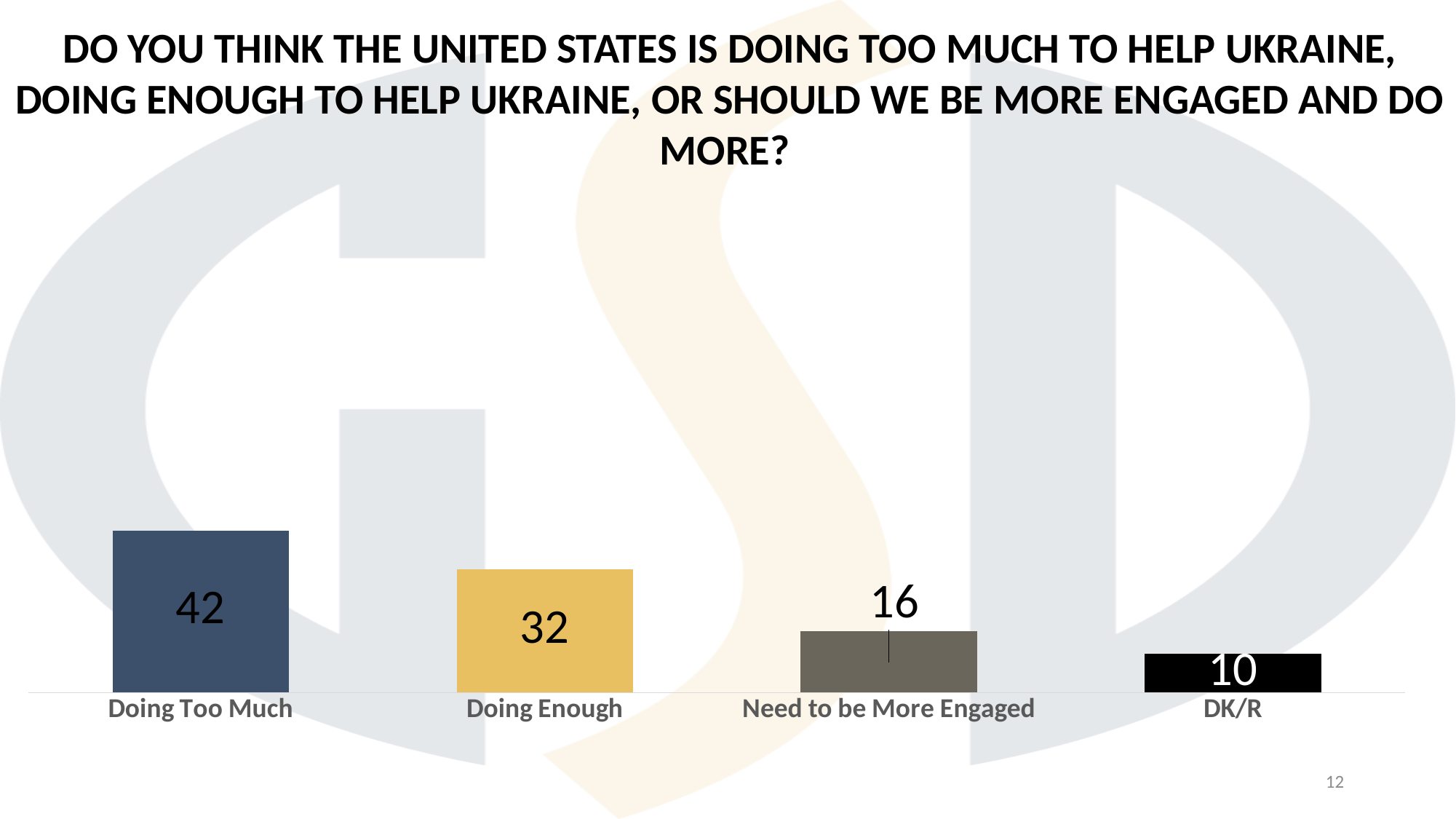
What is the difference between the values for Doing Too Much and Doing Enough? 10 Which category has the highest value? Doing Too Much Do the values rise or fall from left to right across the categories? Fall What is the value for DK/R? 10 What is the value for Need to be More Engaged? 16 What is the value for Doing Too Much? 42 How many categories are shown in the chart? 4 Which category has the lowest value? DK/R What is the difference between the values for Need to be More Engaged and DK/R? 6 What is the value for Doing Enough? 32 Which is larger, the value for Doing Enough or the value for Need to be More Engaged? Doing Enough What kind of chart is shown on the slide? Bar chart